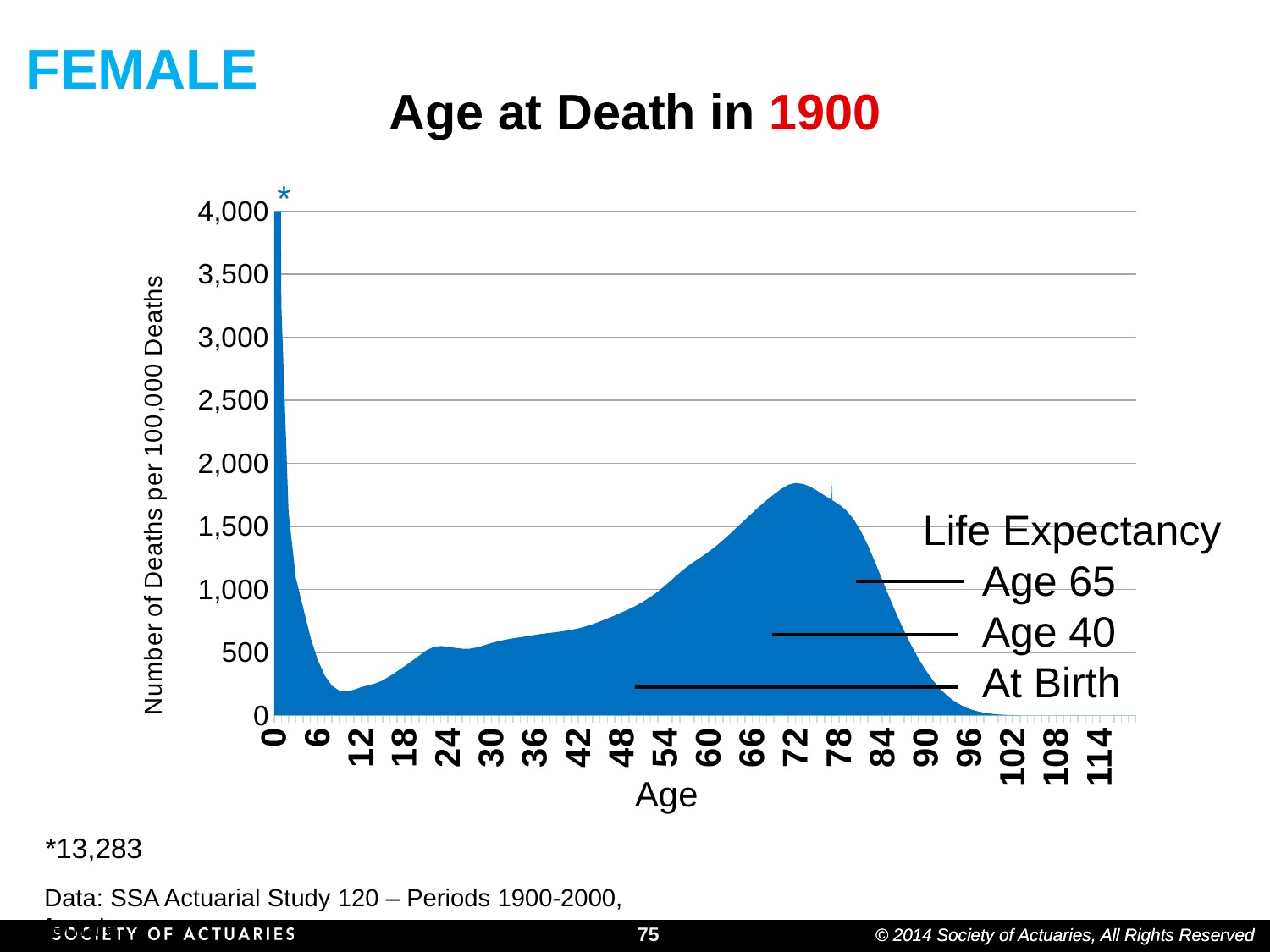
Do the values rise or fall as age increases from 12 to 72? Rise At which age is the number of deaths highest? 0 Do the values rise or fall as age increases from 72 to 102? Fall Is the value at age 72 greater or less than 1,500? greater Which has a larger value, age 24 or age 72? Age 72 Is the value at age 48 greater or less than 500? greater What is the title of the chart? Age at Death in 1900 What kind of chart is shown on the slide? Area chart Is the value at age 90 greater or less than 1,000? less What is the label of the vertical axis? Number of Deaths per 100,000 Deaths What is the value at age 0, as given by the asterisk footnote? 13,283